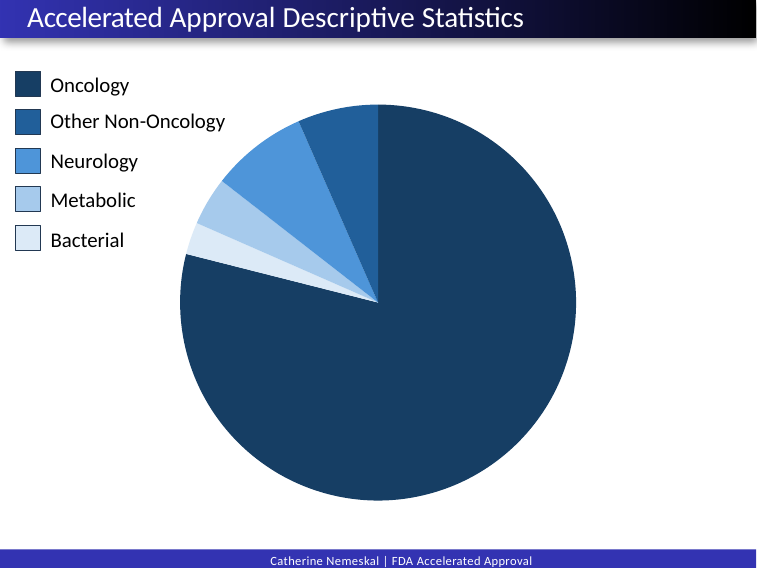
Does the Oncology slice account for more or less than half of the pie? more Which category has the smallest slice of the pie? Bacterial How many categories does the pie chart have? 5 Which slice is larger, Oncology or Neurology? Oncology Which category has the largest slice of the pie? Oncology Which category is listed first in the legend? Oncology Which slice is larger, Metabolic or Bacterial? Metabolic What is the title of the slide containing the pie chart? Accelerated Approval Descriptive Statistics How many entries does the legend list? 5 What kind of chart is shown on the slide? pie chart